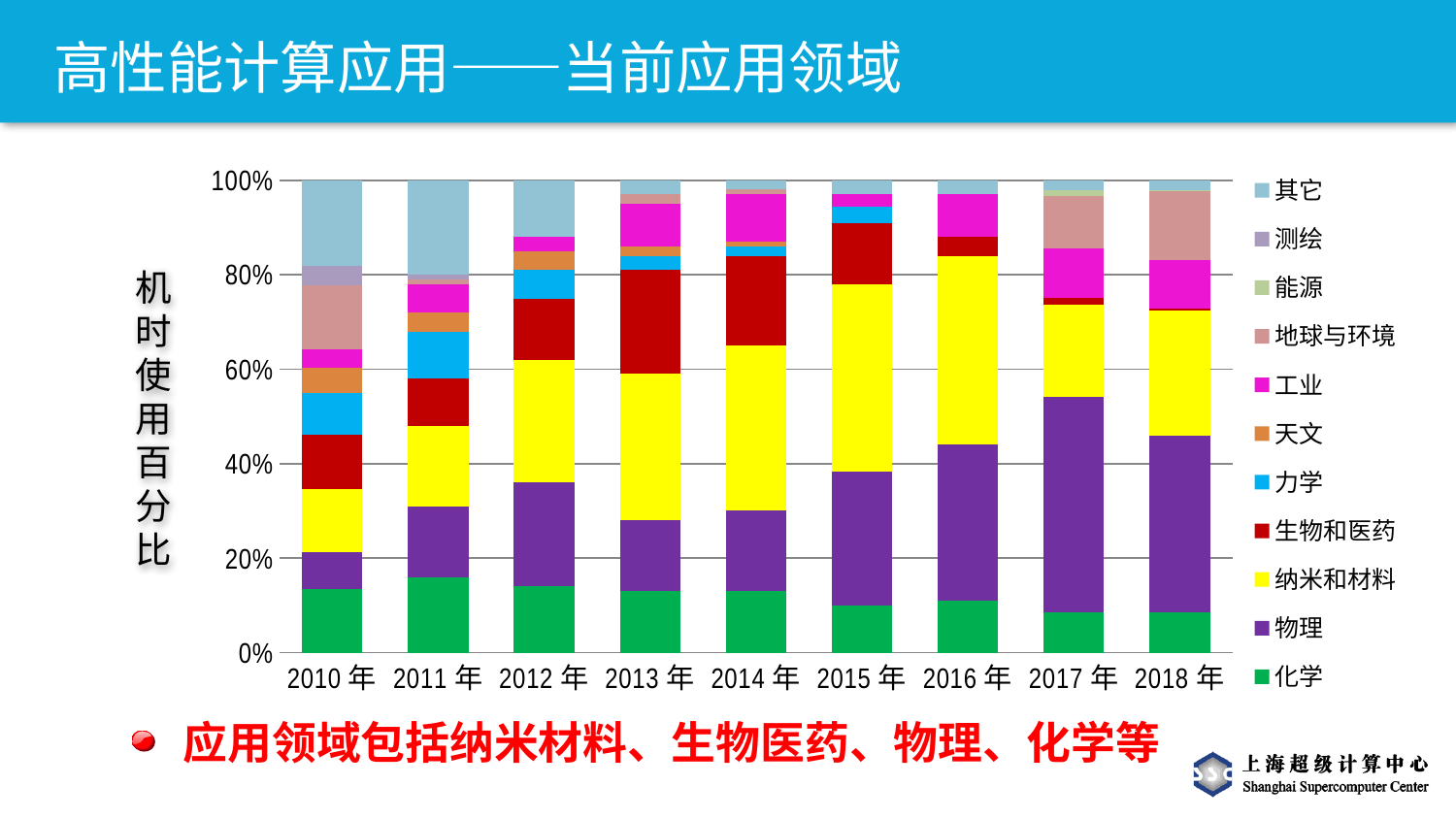
Is the share for 化学 in 2010 年 greater or less than 20%? less Is the share for 物理 in 2017 年 greater or less than 40%? greater Is the share for 物理 larger in 2010 年 or in 2018 年? 2018 年 What is the label on the vertical axis of the chart? 机时使用百分比 What is the first year shown on the x axis? 2010 年 What kind of chart is shown on the slide? stacked bar chart How many years are shown along the x axis of the chart? 9 Is the share for 其它 larger in 2010 年 or in 2018 年? 2010 年 Which year has the largest share for 物理? 2017 年 What is the last year shown on the x axis? 2018 年 Does the share for 物理 generally rise or fall from 2010 年 to 2018 年? rise How many series does the chart's legend list? 11